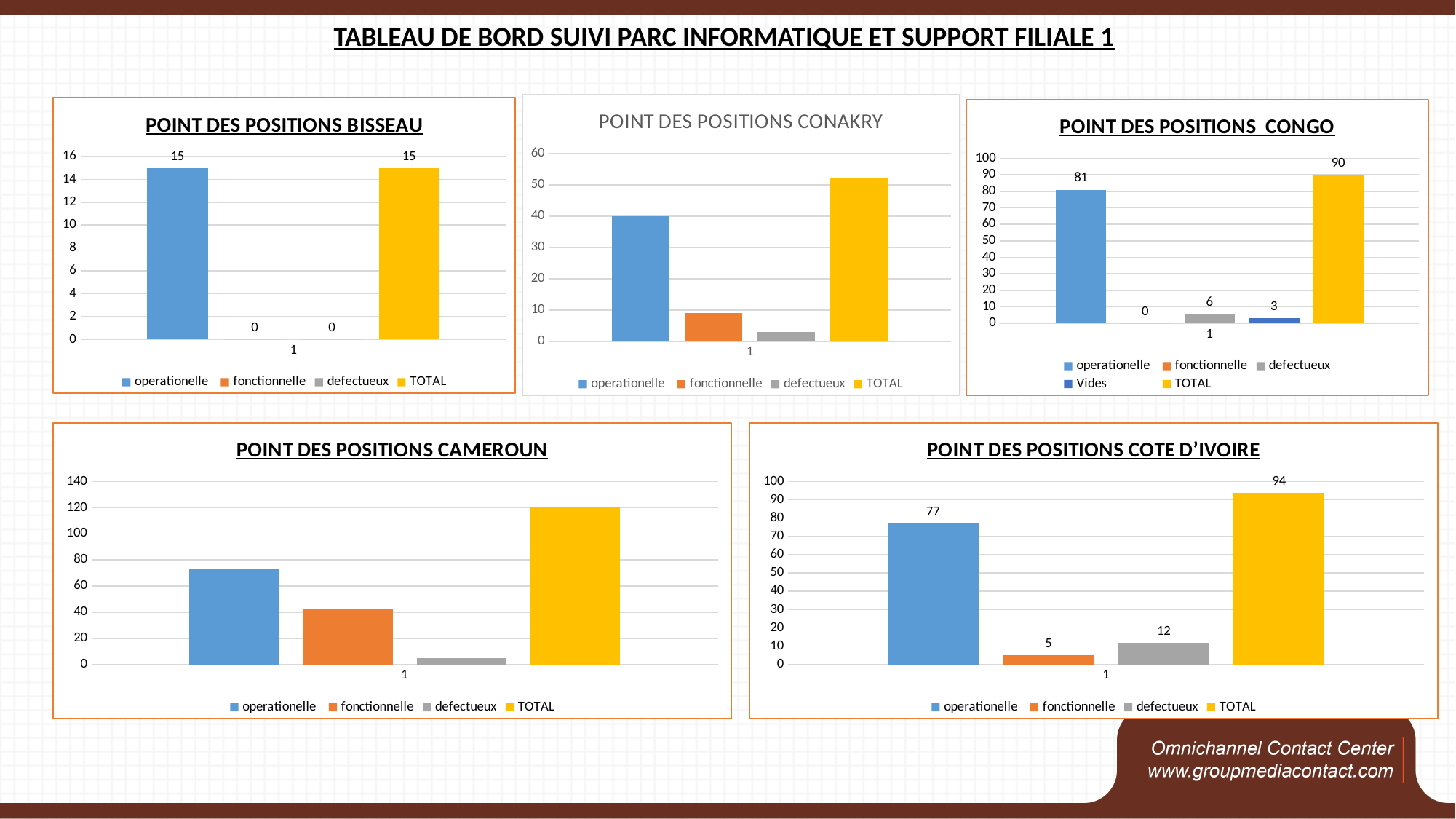
How many charts are shown on the slide? 5 In the POINT DES POSITIONS COTE D'IVOIRE chart, what is the difference between operationelle and defectueux? 65 In the POINT DES POSITIONS CONGO chart, what is the value for TOTAL? 90 In the POINT DES POSITIONS CAMEROUN chart, is the value for fonctionnelle greater or less than 60? less In the POINT DES POSITIONS COTE D'IVOIRE chart, which series has the highest value? TOTAL What kind of chart is the POINT DES POSITIONS CAMEROUN chart? bar chart In the POINT DES POSITIONS COTE D'IVOIRE chart, what is the value for defectueux? 12 In the POINT DES POSITIONS CONGO chart, which is larger, defectueux or Vides? defectueux In the POINT DES POSITIONS CONGO chart, what is the value for Vides? 3 In the POINT DES POSITIONS BISSEAU chart, what is the value for operationelle? 15 In the POINT DES POSITIONS CONAKRY chart, is the value for operationelle greater or less than 30? greater How many series does the legend of the POINT DES POSITIONS CONGO chart list? 5